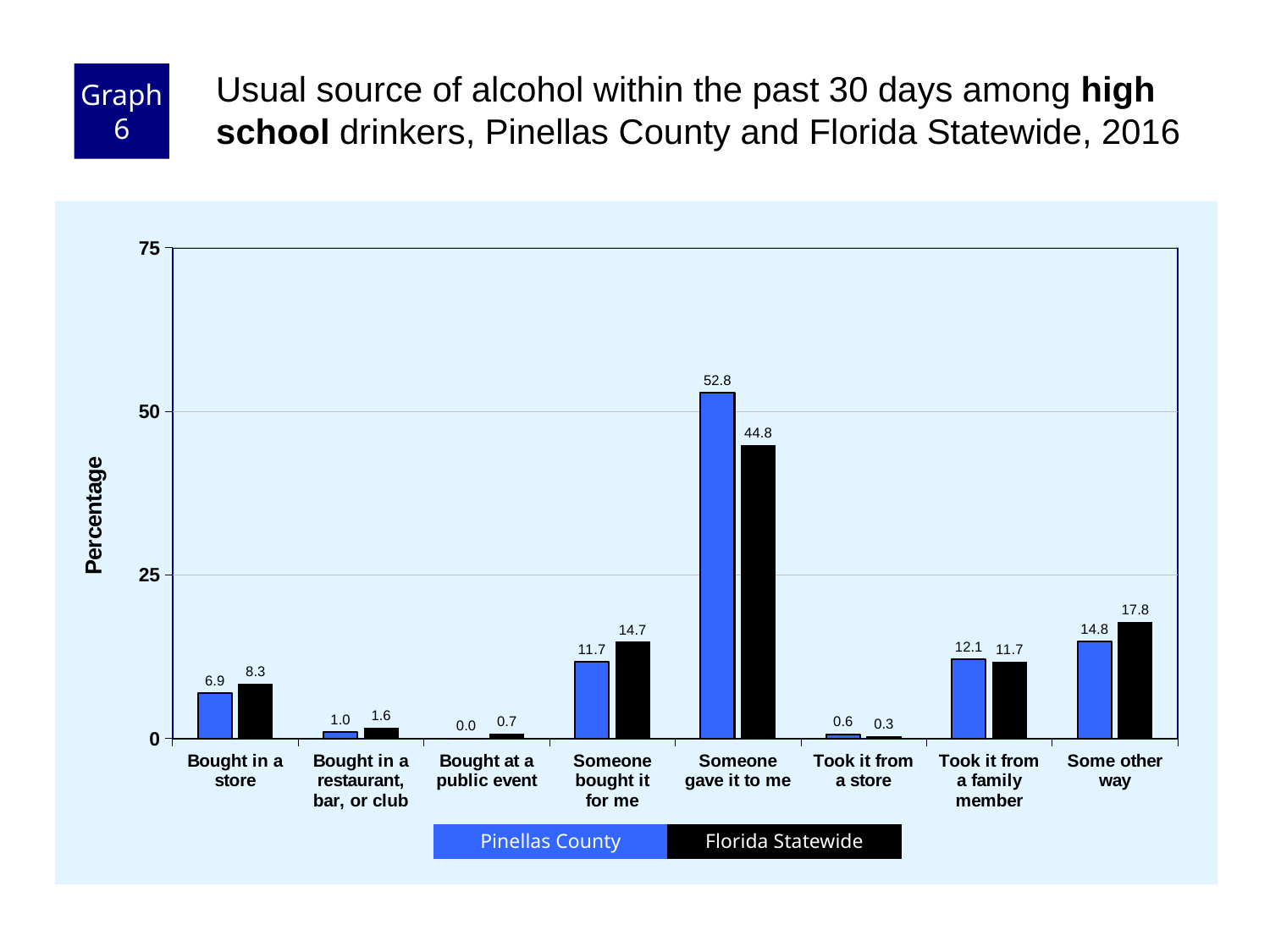
Is the Florida Statewide value for "Someone gave it to me" greater or less than 50? less What is the Florida Statewide value for "Some other way"? 17.8 Which category has the lowest Pinellas County value? Bought at a public event What is the Pinellas County value for "Someone gave it to me"? 52.8 Which is larger for "Took it from a family member": Pinellas County or Florida Statewide? Pinellas County What is the difference between the Pinellas County and Florida Statewide values for "Someone gave it to me"? 8.0 How many categories are shown on the x axis? 8 Which category has the highest Florida Statewide value? Someone gave it to me What is the label of the y axis? Percentage How many series does the legend list? 2 What is the Pinellas County value for "Bought at a public event"? 0.0 What kind of chart is shown on the slide? Bar chart